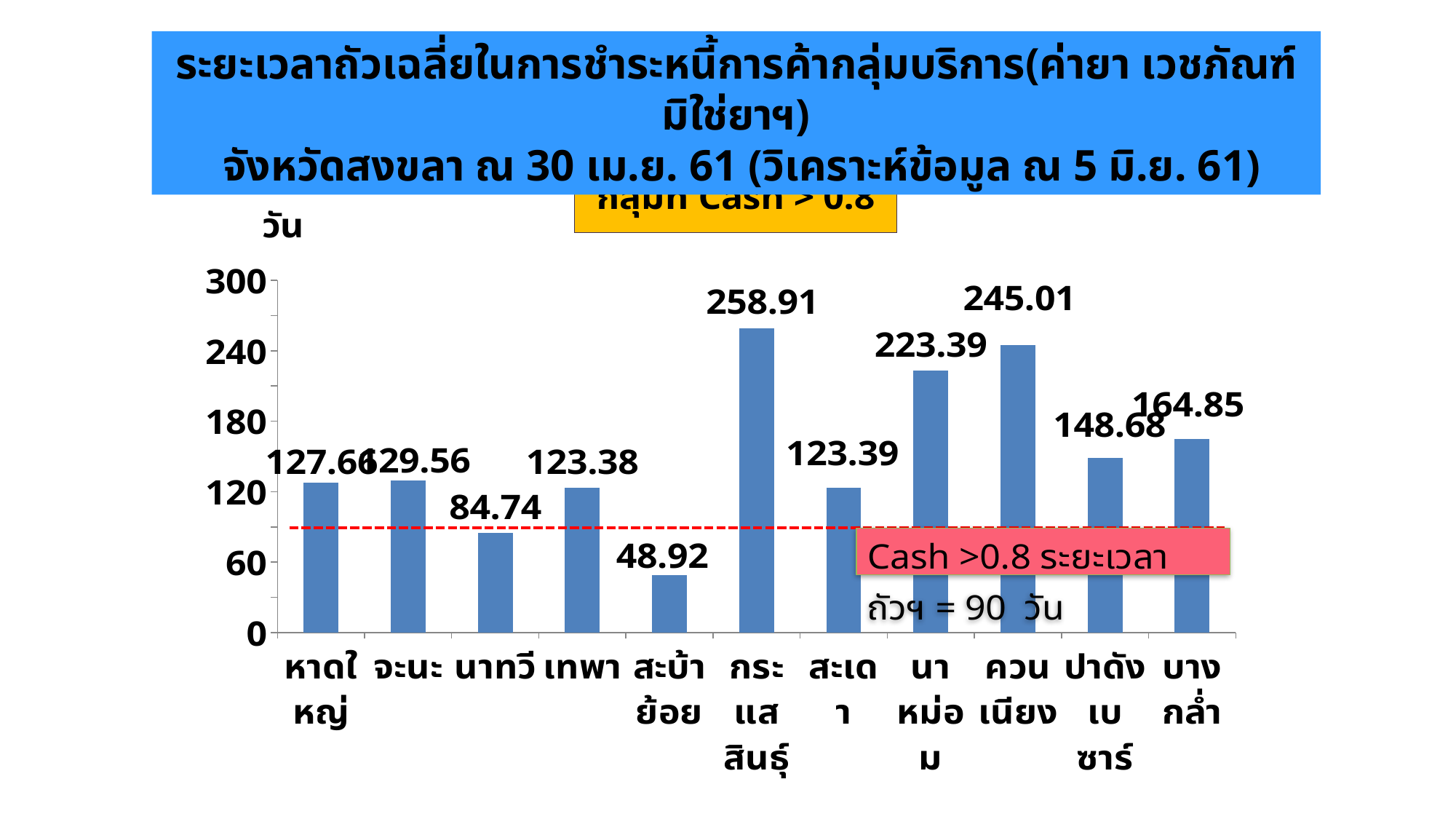
How many categories are shown on the x axis? 11 Which category has the highest value? กระแสสินธุ์ What is the difference between the values for บางกล่ำ and ปาดังเบซาร์? 16.17 What is the value for สะบ้าย้อย? 48.92 What is the value for กระแสสินธุ์? 258.91 What is the value for นาหม่อม? 223.39 Is the value for นาทวี greater or less than 120? less Which category has the lowest value? สะบ้าย้อย Which is larger, the value for บางกล่ำ or the value for ปาดังเบซาร์? บางกล่ำ What kind of chart is shown on the slide? bar chart What is the difference between the values for ควนเนียง and นาหม่อม? 21.62 What is the value for เทพา? 123.38